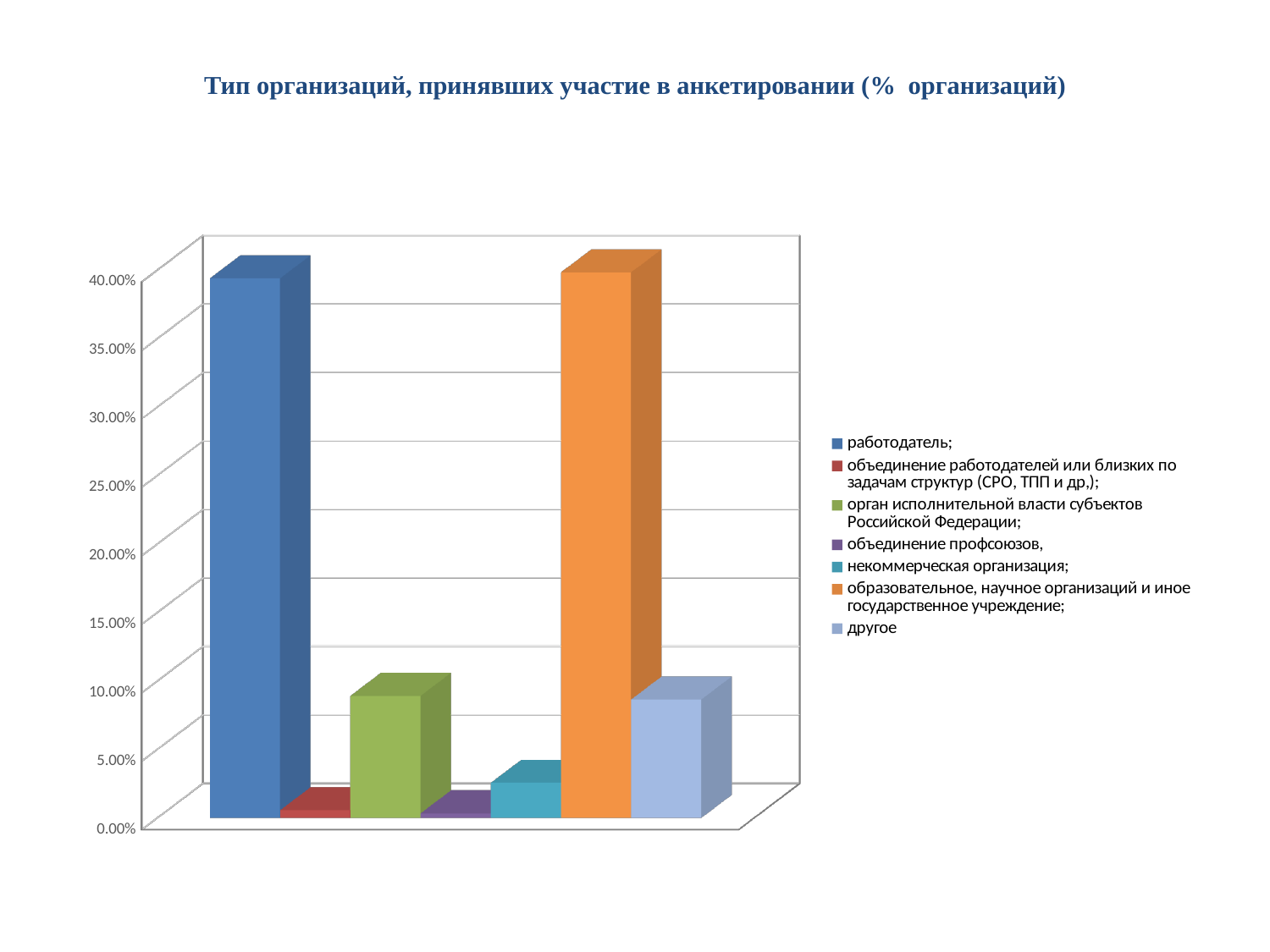
Is the value for объединение работодателей или близких по задачам структур (СРО, ТПП и др.) greater or less than 5.00%? less Is the value for другое greater or less than 15.00%? less Is the value for орган исполнительной власти субъектов Российской Федерации greater or less than 15.00%? less How many bars are plotted in the chart? 7 What kind of chart is shown on the slide? bar chart Which is larger, the value for работодатель or the value for орган исполнительной власти субъектов Российской Федерации? работодатель How many series does the legend list? 7 What is the title of the chart? Тип организаций, принявших участие в анкетировании (% организаций)